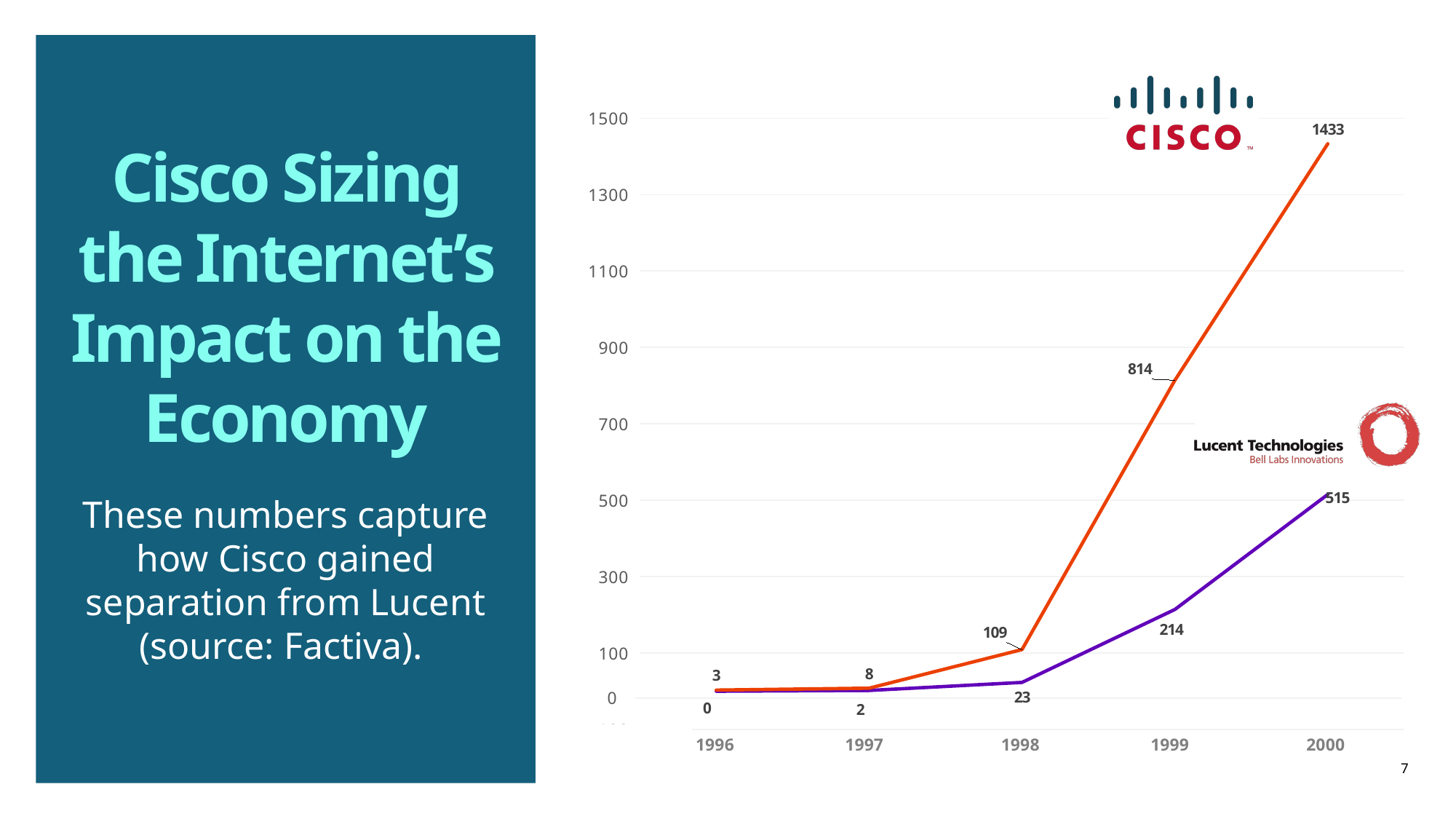
What is the value for Cisco in 2000? 1433 Which is larger in 1999, the Cisco value or the Lucent Technologies value? Cisco What is the value for Lucent Technologies in 1999? 214 In which year is the Lucent Technologies value lowest? 1996 How many years are plotted along the x axis? 5 In which year does the Cisco line reach its highest value? 2000 What is the value for Cisco in 1998? 109 What is the value for Lucent Technologies in 1996? 0 Which company's line is drawn in purple? Lucent Technologies What is the difference between the Cisco and Lucent Technologies values in 2000? 918 Do the Cisco values rise or fall from 1996 to 2000? rise What kind of chart is shown on the slide? line chart